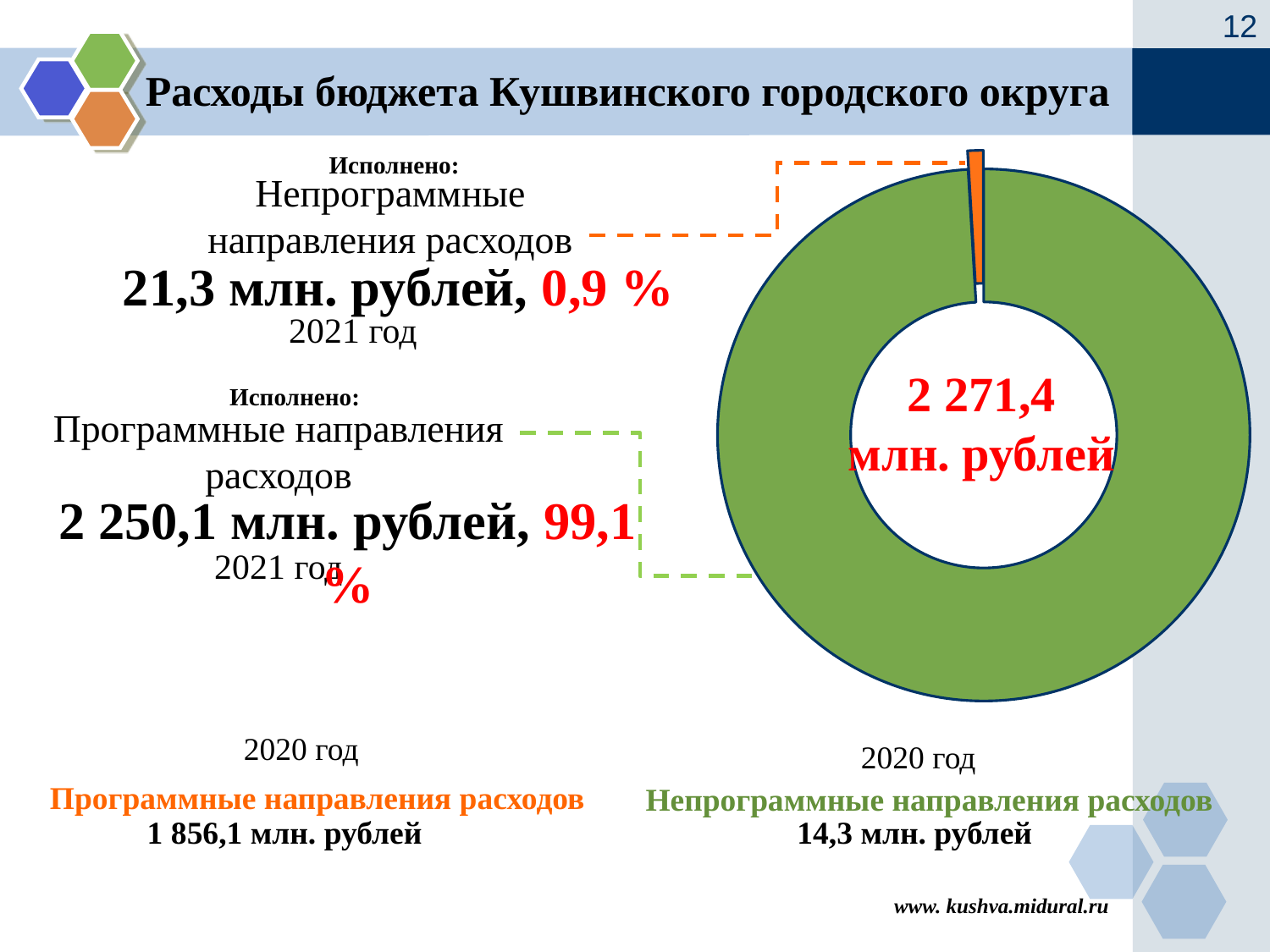
What share of the doughnut chart does Непрограммные направления расходов take? 0,9 % Which slice of the doughnut chart is the largest? Программные направления расходов What colour is the slice for Непрограммные направления расходов in the doughnut chart? Orange How many slices does the doughnut chart have? 2 Which is larger in 2021: Программные направления расходов or Непрограммные направления расходов? Программные направления расходов Which slice of the doughnut chart is the smallest? Непрограммные направления расходов What kind of chart is shown on the slide? Doughnut (pie) chart What is the difference between Программные направления расходов and Непрограммные направления расходов in 2021? 2 228,8 млн. рублей What share of the doughnut chart does Программные направления расходов take? 99,1 % What is the value for Непрограммные направления расходов in 2021? 21,3 млн. рублей What total is shown in the centre of the doughnut chart? 2 271,4 млн. рублей What is the value for Программные направления расходов in 2021? 2 250,1 млн. рублей